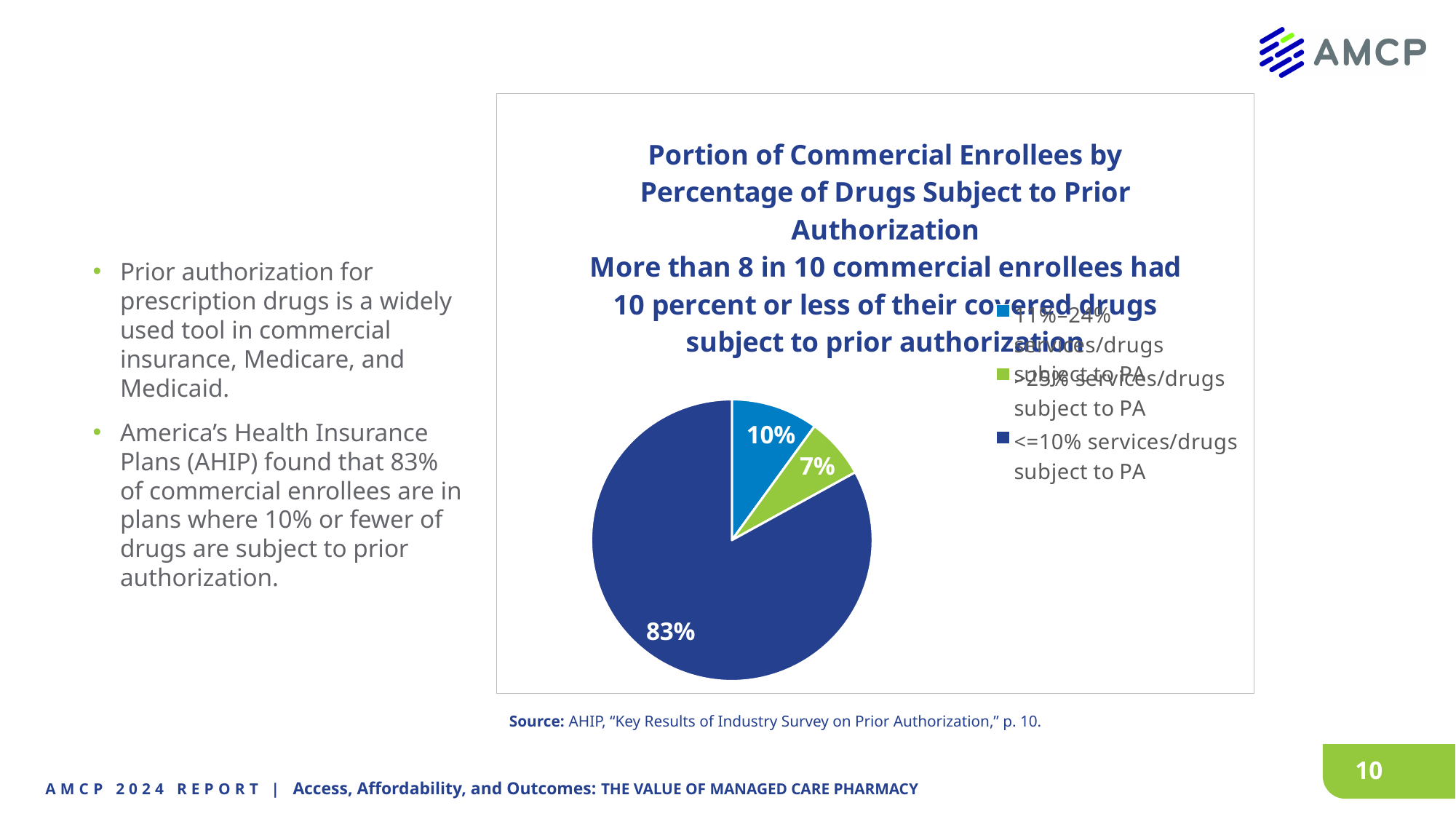
What kind of chart is shown on the slide? pie chart What share of commercial enrollees had <=10% services/drugs subject to PA? 83% Which category has the largest slice of the pie chart? <=10% services/drugs subject to PA What is the difference between the largest slice (83%) and the light blue slice (10%)? 73 percentage points How many slices does the pie chart have? 3 What colour is the slice for <=10% services/drugs subject to PA? dark blue How many entries does the legend of the pie chart list? 3 What value is shown on the green slice of the pie chart? 7% What value is shown on the light blue slice of the pie chart? 10% What is the smallest value shown on the pie chart? 7% Which is larger, the light blue slice or the green slice? the light blue slice According to the chart title, more than how many in 10 commercial enrollees had 10 percent or less of their covered drugs subject to prior authorization? 8 in 10